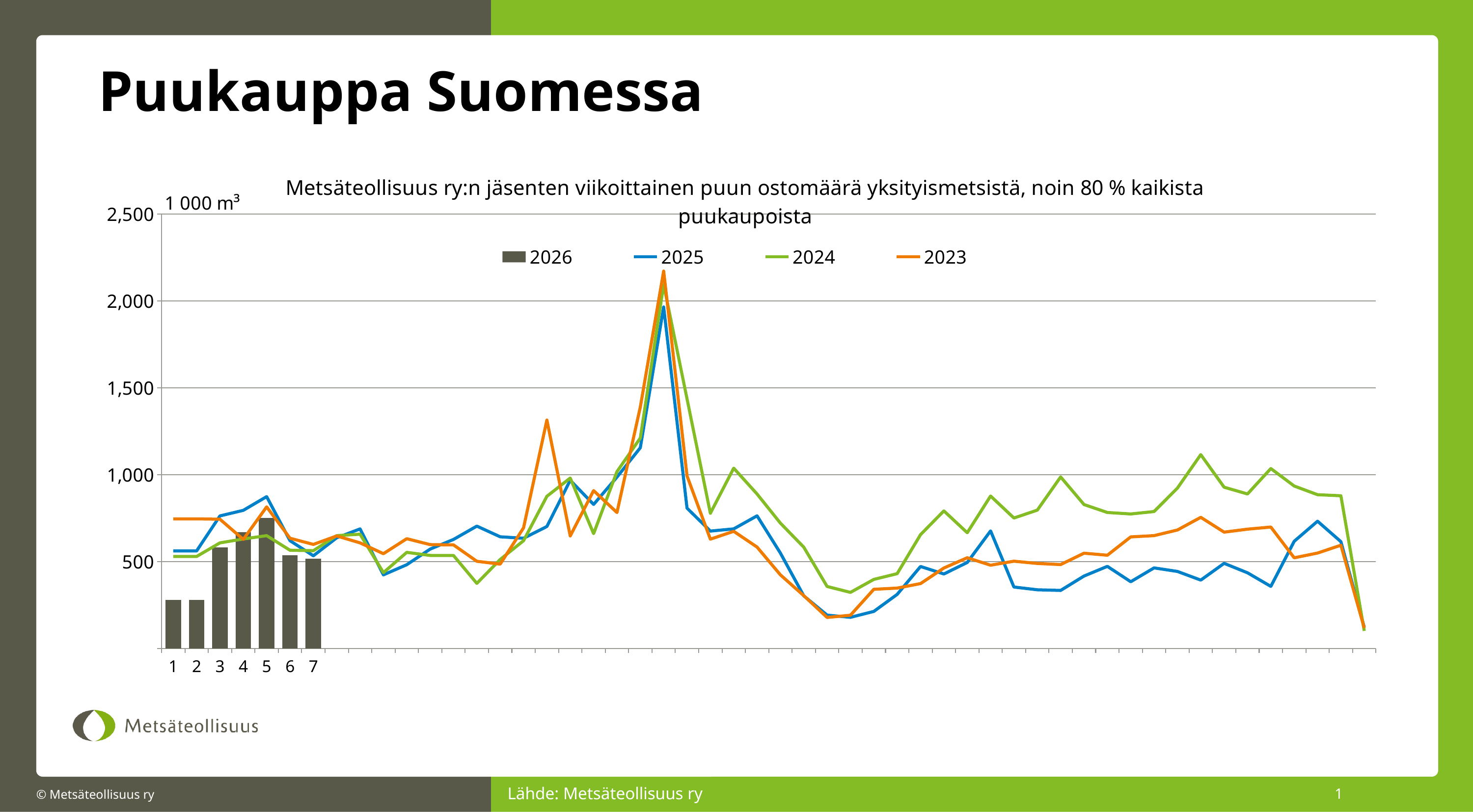
Which is larger, the 2026 bar for week 1 or the 2026 bar for week 5? Week 5 Is the 2026 value for week 1 greater or less than 500? less Which week has the highest 2026 bar? 5 Which year's line reaches the highest peak on the chart? 2023 What kind of chart is used for the 2026 series? Bar chart Is the 2026 value for week 4 greater or less than 500? greater How many series does the chart legend list? 4 What unit is shown on the vertical axis of the chart? 1 000 m³ Which years are listed in the chart legend? 2026, 2025, 2024, 2023 Do the 2026 bars rise or fall from week 1 to week 5? rise Is the 2026 value for week 5 greater or less than 500? greater How many bars are plotted for the 2026 series? 7